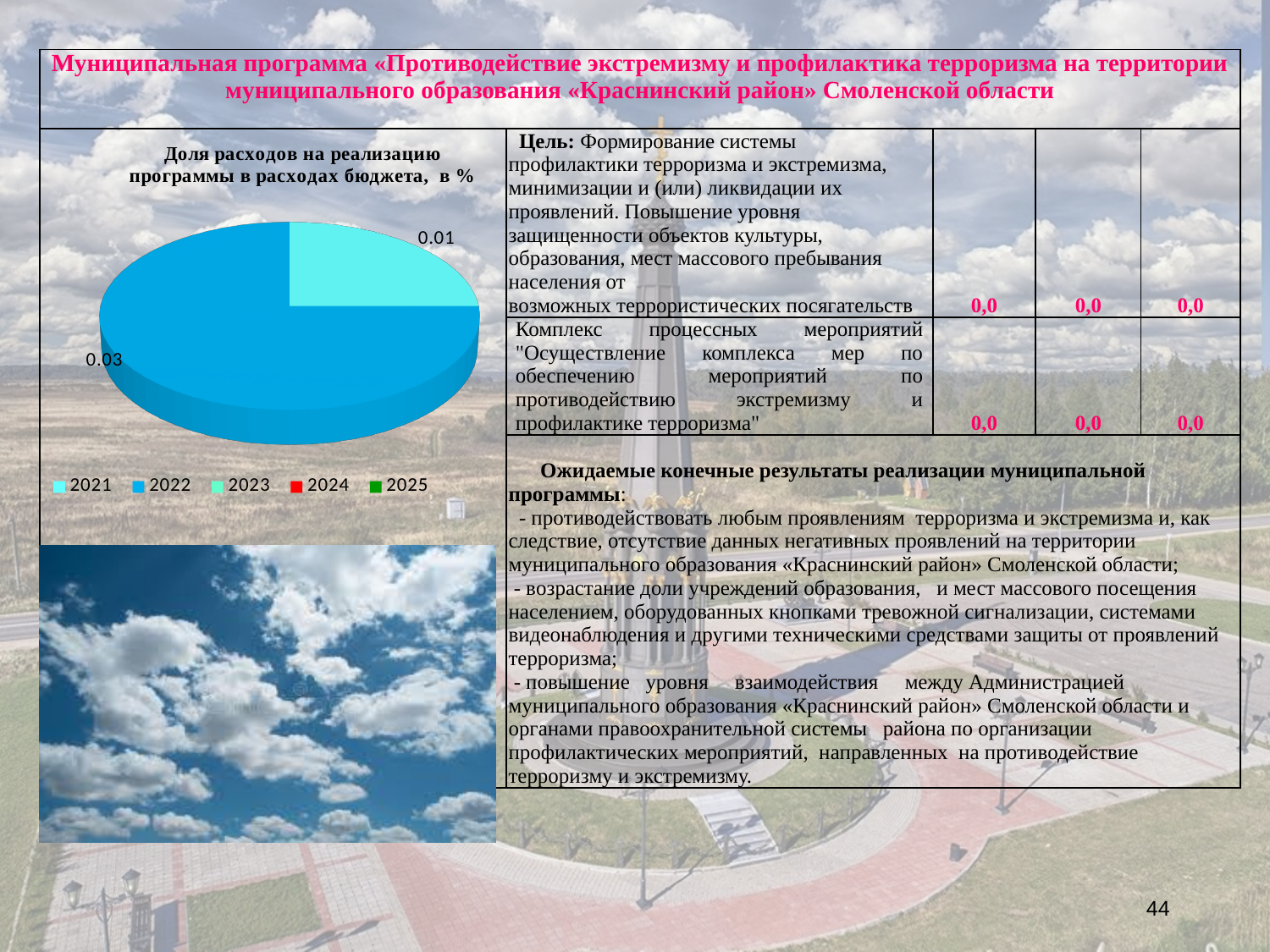
What colour is the slice for 2022 in the pie chart? blue What value is labelled on the pie slice for 2022? 0.03 Which year has the larger slice in the pie chart, 2021 or 2022? 2022 What value is labelled on the pie slice for 2021? 0.01 How many entries does the legend of the pie chart list? 5 How many slices with data labels are visible in the pie chart? 2 What kind of chart is shown on the slide? pie chart What is the title of the pie chart? Доля расходов на реализацию программы в расходах бюджета, в % What is the difference between the labelled values for 2022 and 2021? 0.02 Which year has the largest slice in the pie chart? 2022